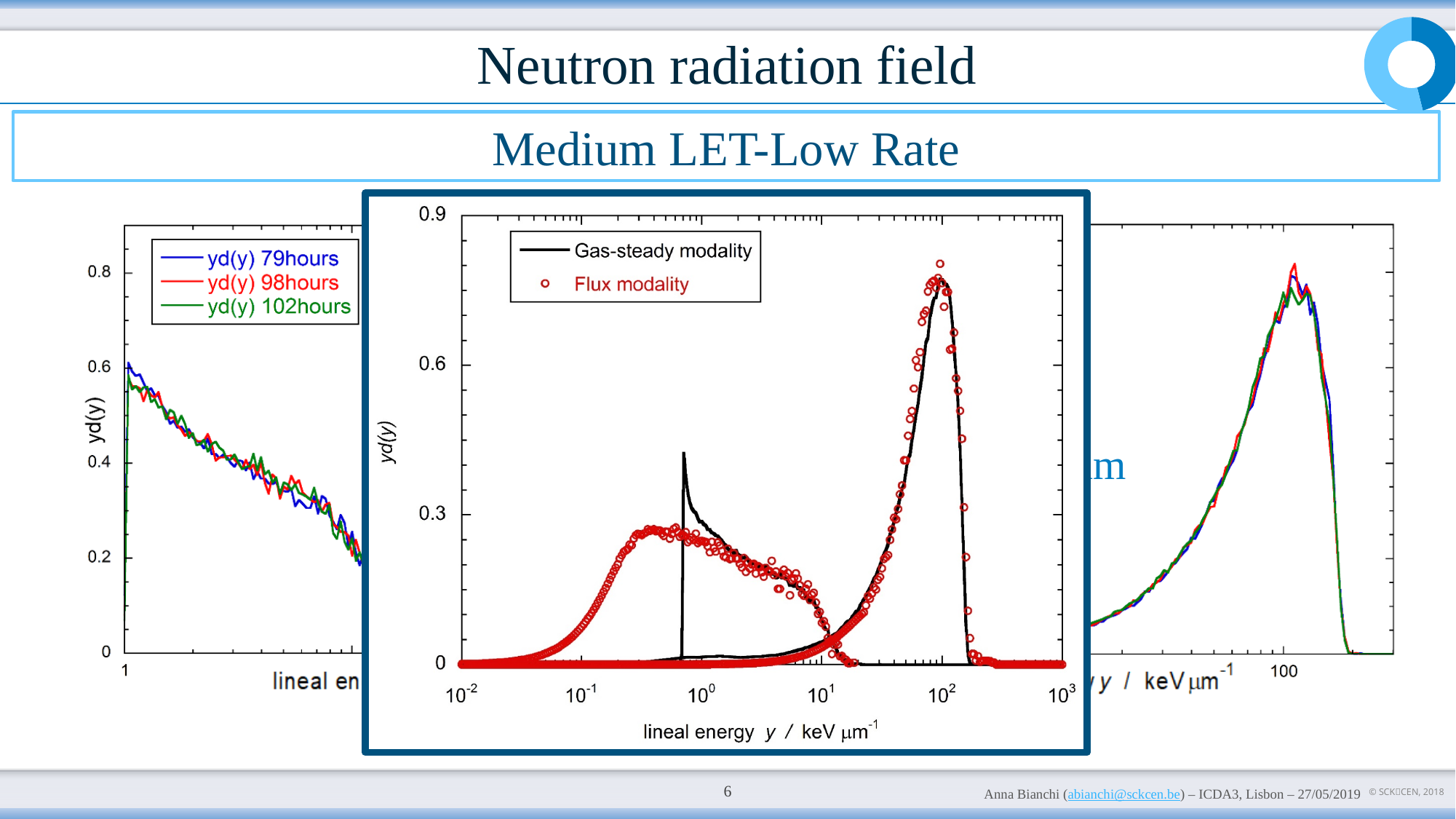
In the central framed chart, is the peak value of the Gas-steady modality curve near 10^2 keV μm-1 greater or less than 0.6? greater In the central framed chart, is the value of the Gas-steady modality curve at 10^-1 keV μm-1 greater or less than 0.3? less In the central framed chart, how many series does the legend list? 2 What kind of chart is the central framed chart? Line chart In the central framed chart, what is the label of the x axis? lineal energy y / keV μm-1 In the central framed chart, what are the two legend entries? Gas-steady modality and Flux modality In the central framed chart, what is the highest value shown on the y axis? 0.9 In the central framed chart, is the value of the Flux modality series at 10^-1 keV μm-1 greater or less than 0.3? less In the central framed chart, does the Gas-steady modality curve reach a higher value near 10^0 or near 10^2 keV μm-1? near 10^2 In the left chart, how many series does the legend list? 3 In the left chart, do the yd(y) values rise or fall as lineal energy increases? fall